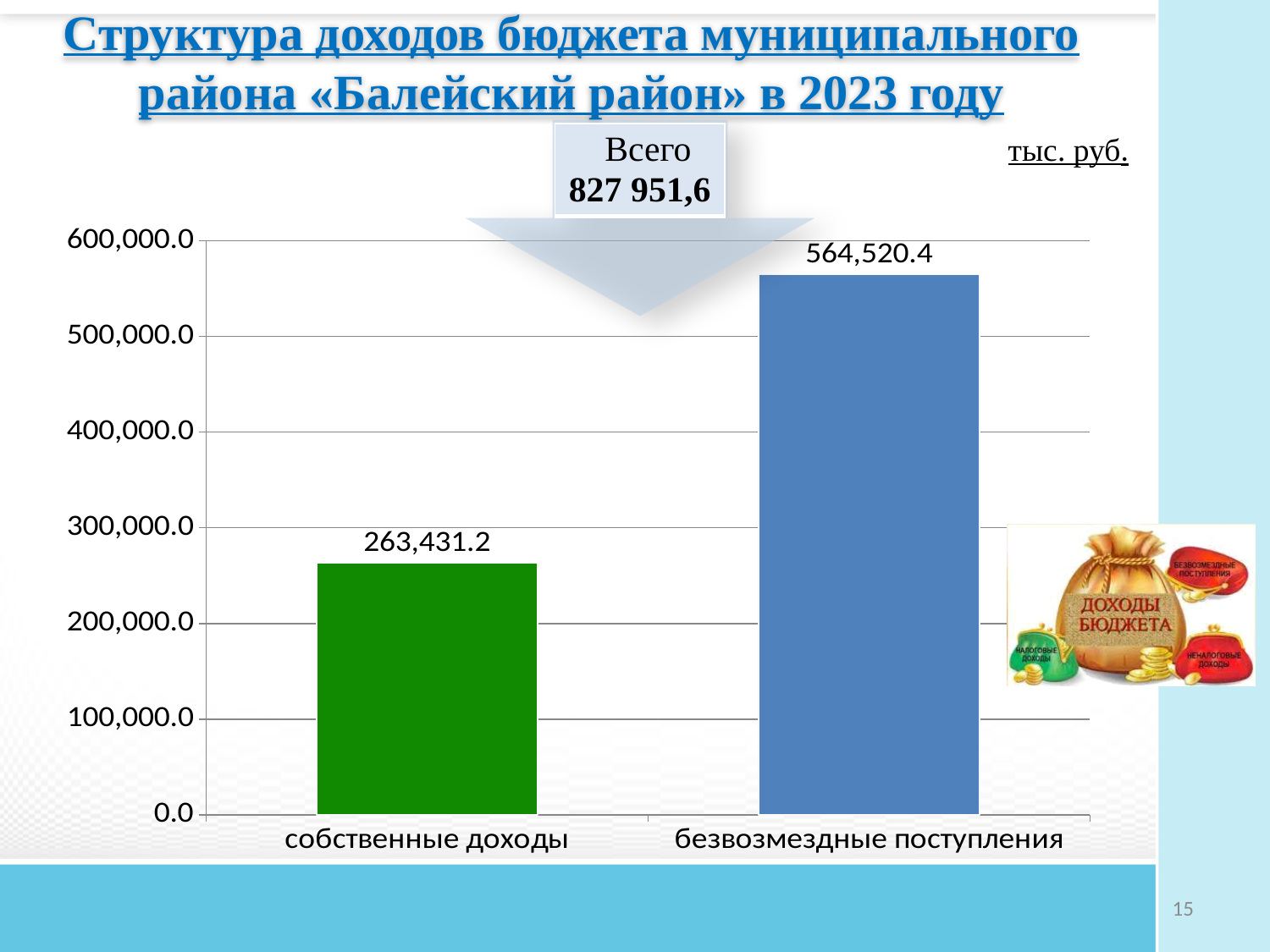
What kind of chart is shown on the slide? bar chart Is the value for «безвозмездные поступления» greater or less than 500,000.0? greater Is the value for «собственные доходы» greater or less than 300,000.0? less Which category has the lowest value? собственные доходы What colour is the bar for «собственные доходы»? green Which category has the highest value? безвозмездные поступления Which is larger: «собственные доходы» or «безвозмездные поступления»? безвозмездные поступления What is the value for «безвозмездные поступления»? 564,520.4 How many categories are shown in the chart? 2 What is the difference between «безвозмездные поступления» and «собственные доходы»? 301,089.2 What is the value for «собственные доходы»? 263,431.2 What total («Всего») is shown above the chart? 827 951,6